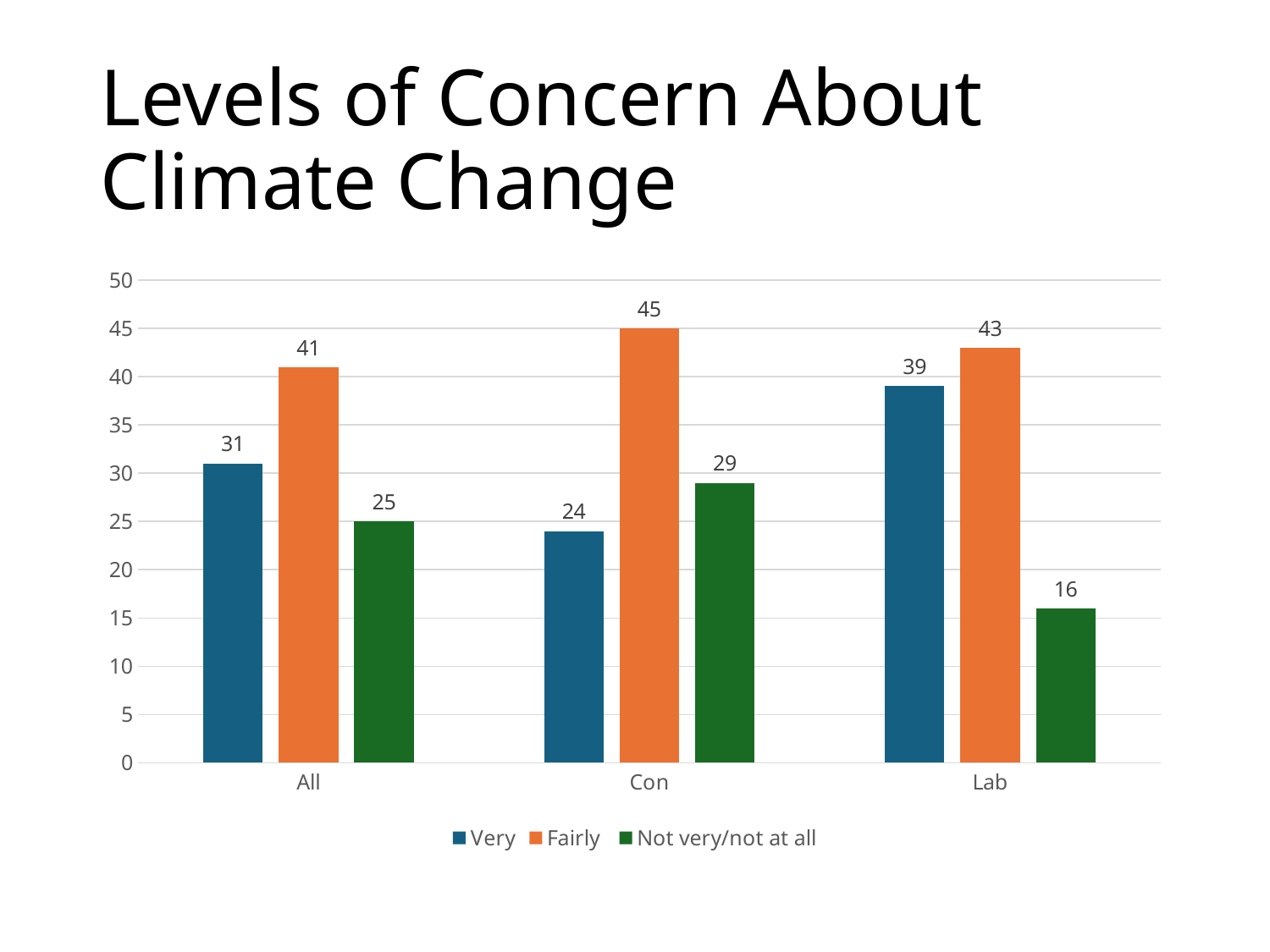
What is the difference between the 'Fairly' values for Con and All? 4 What is the value for 'Fairly' in the Lab category? 43 What is the title of the slide? Levels of Concern About Climate Change Is the 'Not very/not at all' value for Con greater or less than 25? greater Which category has the lowest 'Not very/not at all' value? Lab Which is larger: the 'Very' value for Lab or the 'Very' value for All? Lab Which category has the highest 'Very' value? Lab What is the value for 'Not very/not at all' in the All category? 25 How many series does the legend list? 3 What is the value for 'Very' in the Con category? 24 What kind of chart is shown on the slide? bar chart How many categories are shown on the x axis? 3